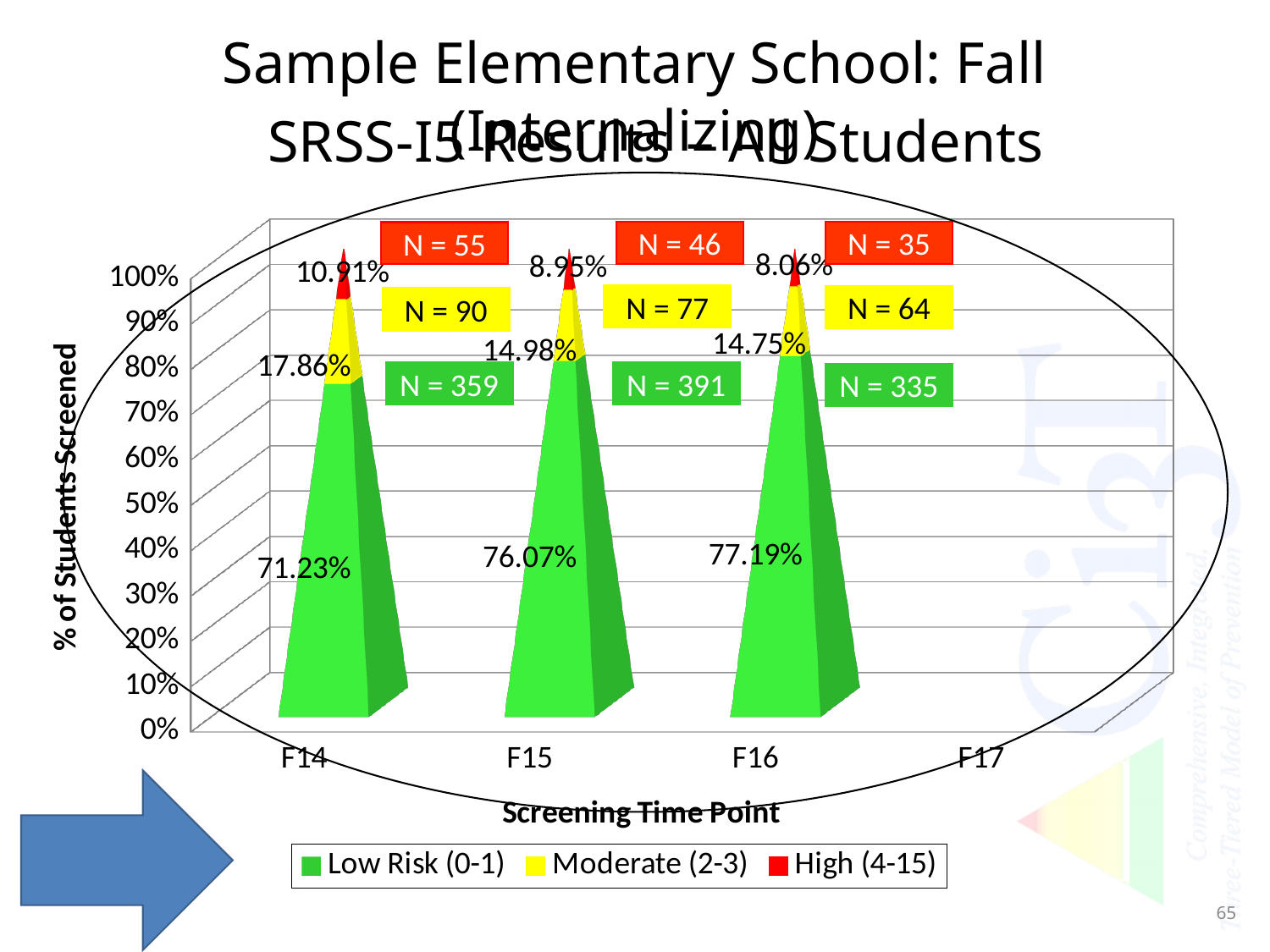
What is the Moderate (2-3) percentage at F15? 14.98% What is the difference between the Low Risk (0-1) percentages at F16 and F14? 5.96% Which screening time point has the lowest High (4-15) percentage? F16 How many series does the legend list? 3 What is the Low Risk (0-1) percentage at F14? 71.23% What is the Moderate (2-3) percentage at F16? 14.75% Does the Low Risk (0-1) percentage rise or fall from F14 to F16? Rise What is the High (4-15) percentage at F16? 8.06% Is the High (4-15) percentage larger at F14 or at F15? F14 What is the title of the x axis? Screening Time Point What kind of chart is shown? Stacked bar chart Which screening time point has the highest Low Risk (0-1) percentage? F16